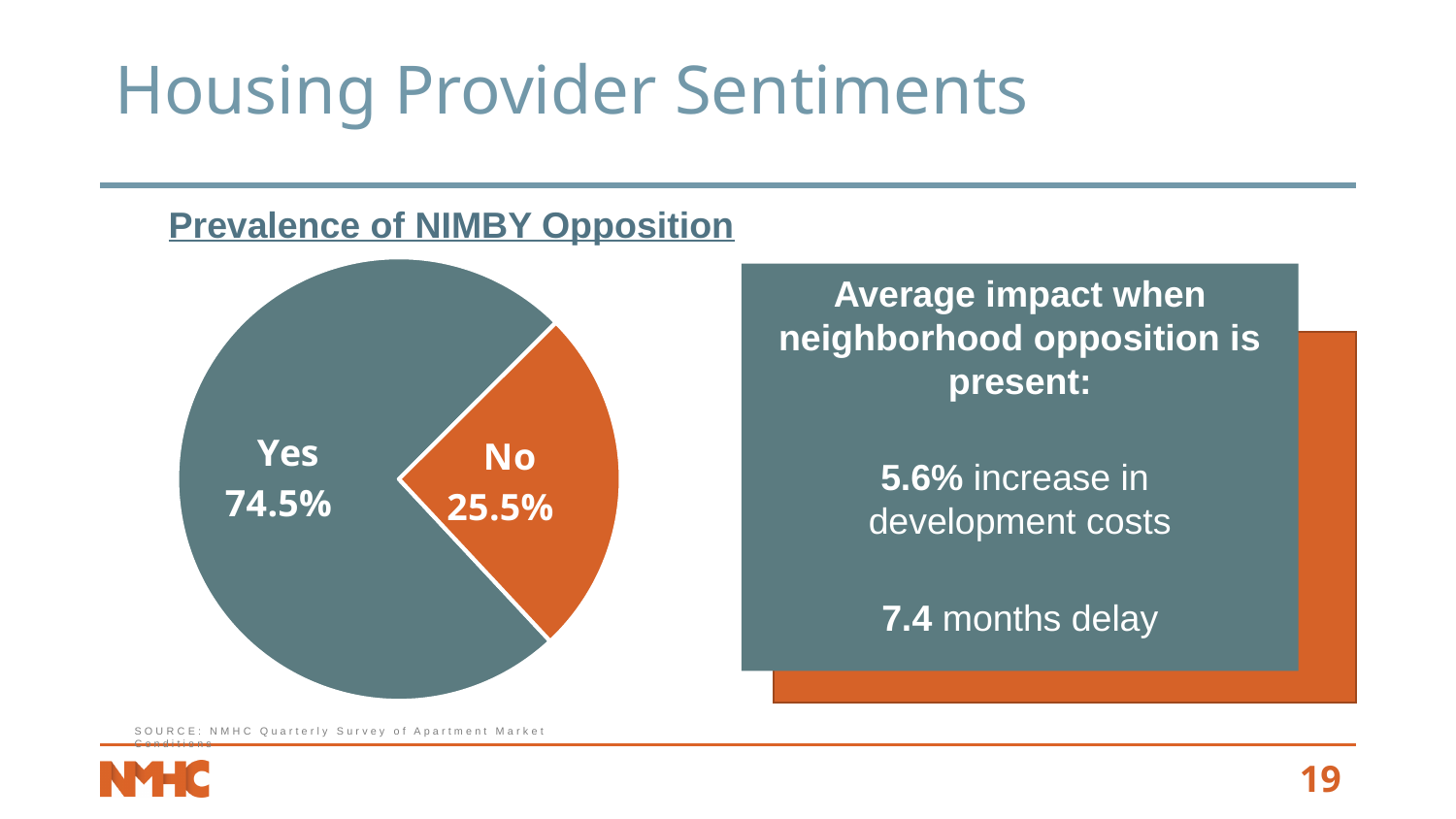
How many slices does the pie chart have? 2 What kind of chart is shown under "Prevalence of NIMBY Opposition"? Pie chart What is the title of the pie chart? Prevalence of NIMBY Opposition What share of the pie chart is labelled "Yes"? 74.5% Which slice of the pie chart is the largest? Yes Is the "No" slice greater or less than 50% of the pie? less By how many percentage points does the "Yes" slice exceed the "No" slice? 49 percentage points What colour is the "No" slice of the pie chart? Orange Which is larger in the pie chart, "Yes" or "No"? Yes What share of the pie chart is labelled "No"? 25.5% Which slice of the pie chart is the smallest? No